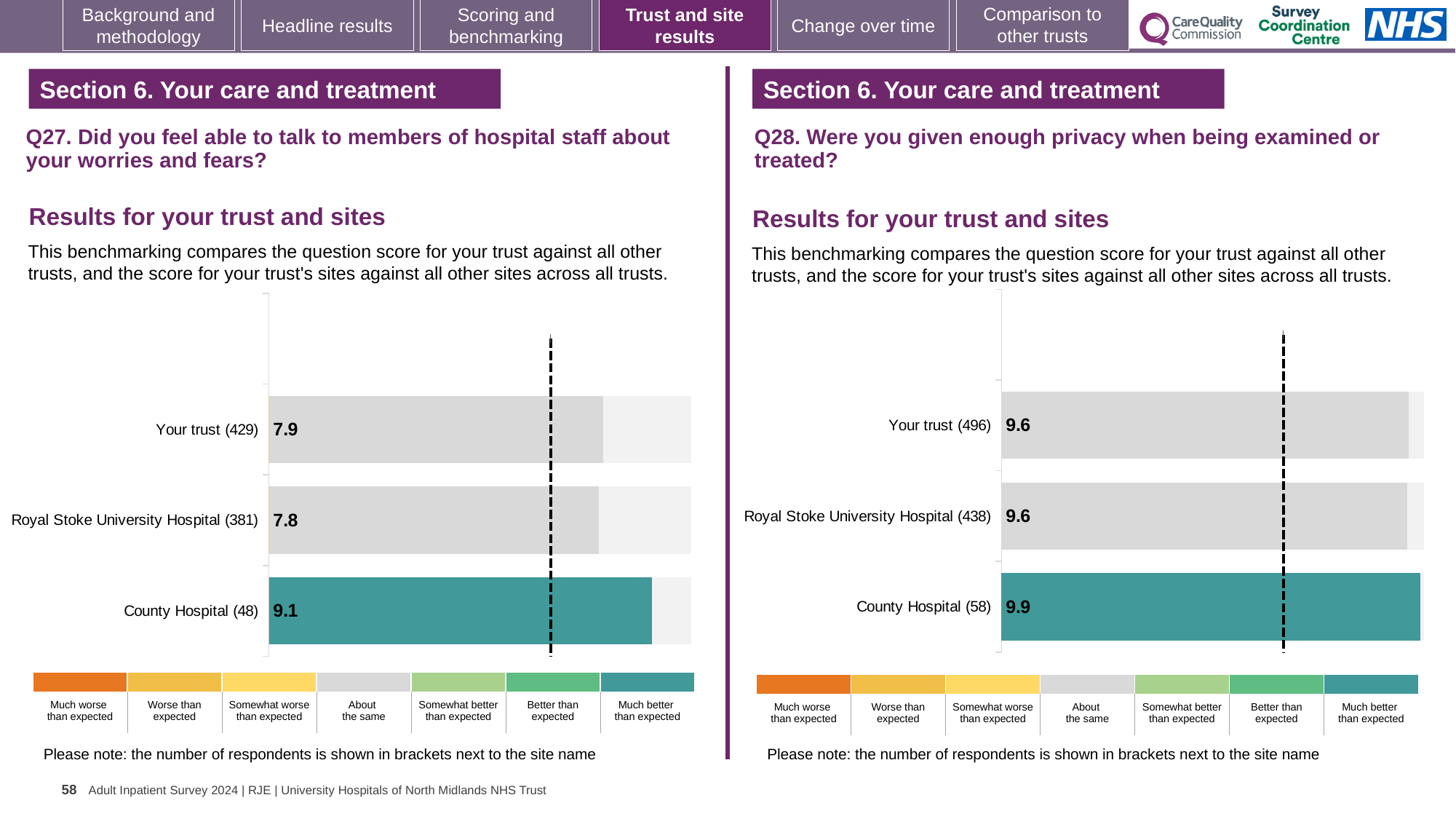
In the Q28 chart on the right, what is the score for Your trust? 9.6 What type of chart is used for the Q28 results on the right? Bar chart In the Q28 chart on the right, what is the difference between the County Hospital score and the Your trust score? 0.3 In the Q28 chart on the right, what is the score for County Hospital? 9.9 In the Q27 chart on the left, what is the difference between the County Hospital score and the Royal Stoke University Hospital score? 1.3 In the Q28 chart on the right, which site or trust has the highest score? County Hospital In the Q27 chart on the left, how many respondents are shown in brackets for County Hospital? 48 In the Q27 chart on the left, what is the score for Your trust? 7.9 In the Q27 chart on the left, what is the score for County Hospital? 9.1 In the Q27 chart on the left, which site or trust has the highest score? County Hospital How many bars are shown in the Q27 chart on the left? 3 In the Q27 chart on the left, what is the score for Royal Stoke University Hospital? 7.8